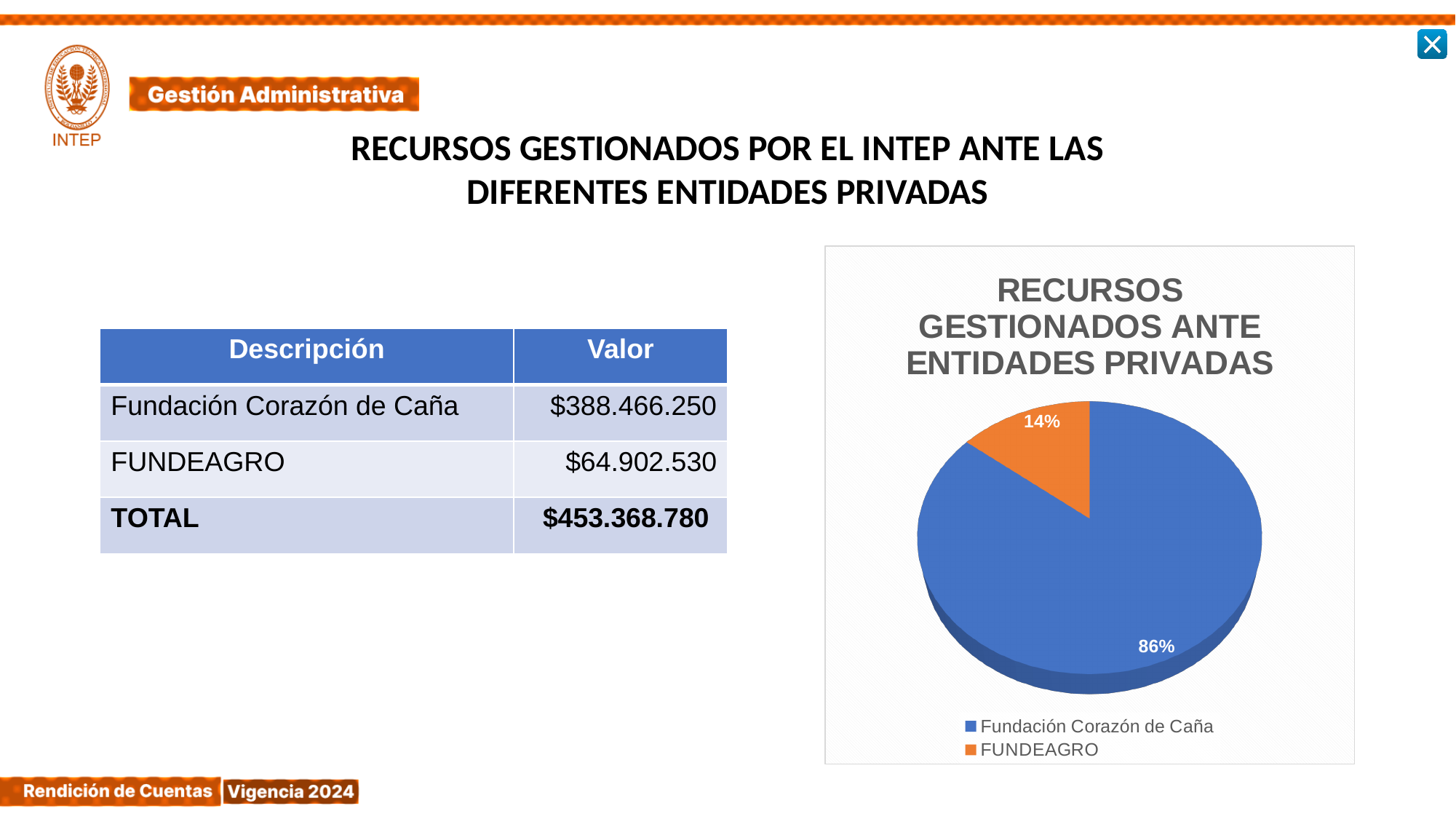
How many slices does the pie chart have? 2 Which slice of the pie is the smallest? FUNDEAGRO What share of the pie does Fundación Corazón de Caña represent? 86% Which is larger, the share for Fundación Corazón de Caña or the share for FUNDEAGRO? Fundación Corazón de Caña What share of the pie does FUNDEAGRO represent? 14% Which slice of the pie is the largest? Fundación Corazón de Caña What is the difference in percentage points between the Fundación Corazón de Caña slice and the FUNDEAGRO slice? 72 What colour is the FUNDEAGRO slice in the pie chart? orange What kind of chart is shown on the slide? pie chart How many entries does the chart legend list? 2 What is the title of the pie chart? RECURSOS GESTIONADOS ANTE ENTIDADES PRIVADAS